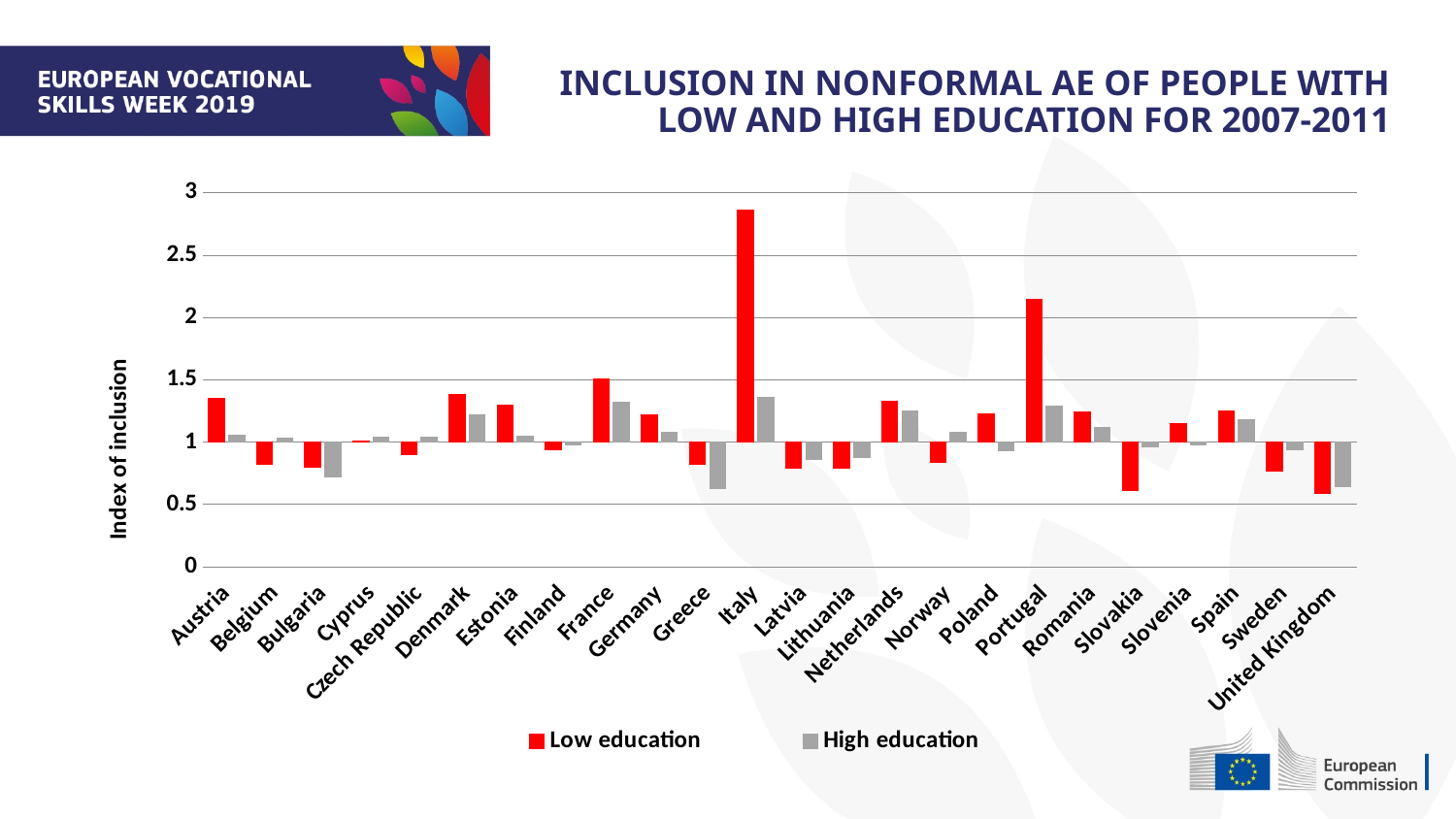
What kind of chart is shown on the slide? Bar chart Which colour represents the Low education series? Red Is the High education value for Greece greater or less than 0.5? greater Which country has the highest Low education value? Italy Is the Low education value for Austria greater or less than 1.5? less Is the Low education value for Portugal greater or less than 1.5? greater How many countries are shown on the x axis? 24 For Greece, which is larger: the Low education value or the High education value? Low education For Italy, which is larger: the Low education value or the High education value? Low education How many series does the legend list? 2 What is the title of the y axis? Index of inclusion